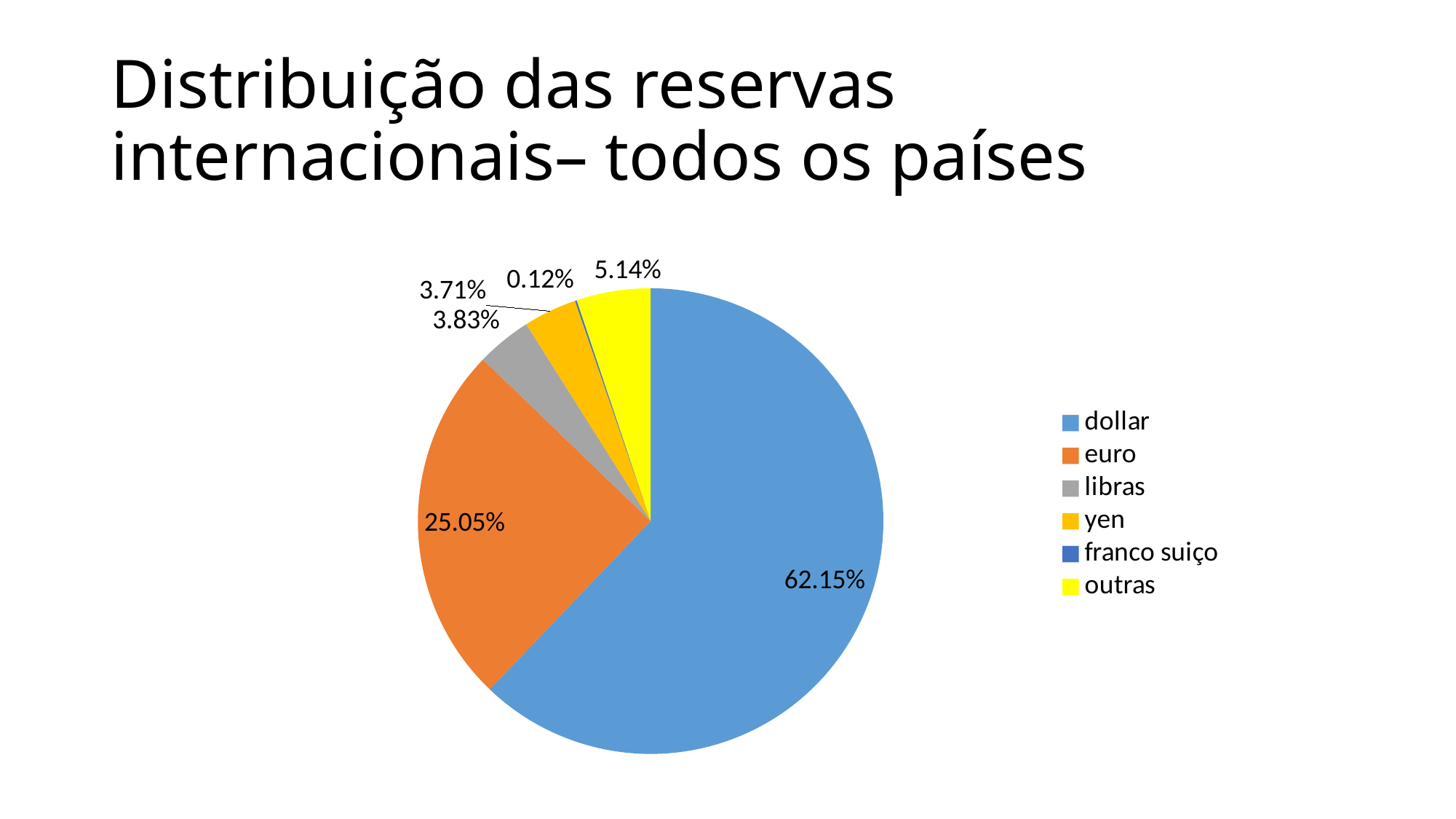
What is the value shown for libras? 3.83% Which category has the largest slice of the pie? dollar What is the value shown for outras? 5.14% What is the value shown for yen? 3.71% What kind of chart is shown on the slide? pie chart What is the difference between the dollar share and the euro share? 37.10% Which category has the smallest slice of the pie? franco suiço What is the value shown for euro? 25.05% What share of the pie does dollar hold? 62.15% What is the value shown for franco suiço? 0.12% How many categories does the legend list? 6 Which is larger, the share for outras or the share for yen? outras